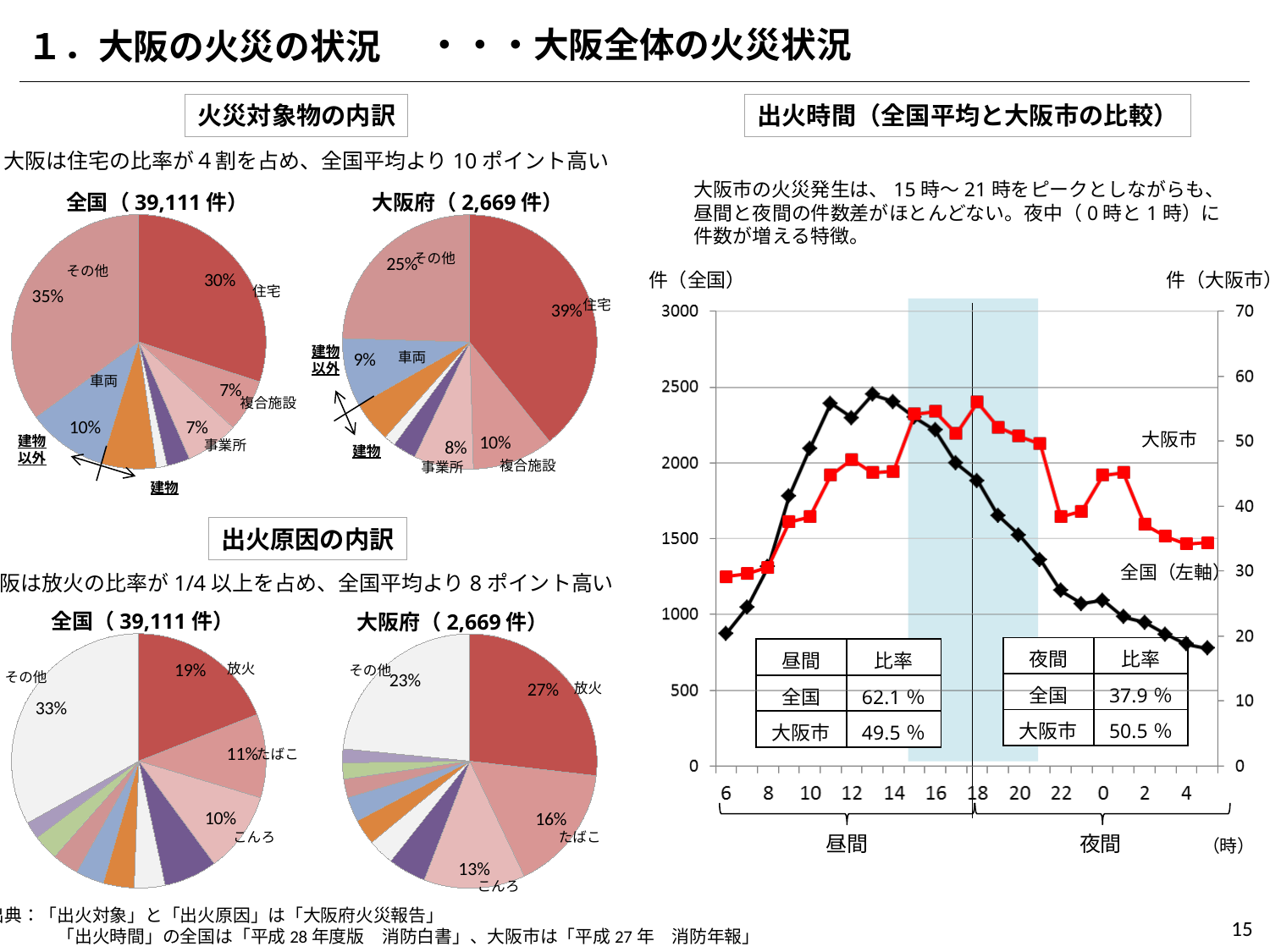
In the 出火時間 chart, is the 全国 value at 6時 greater or less than 1000? less In the 出火原因の内訳 pie chart for 大阪府 (2,669件), which is larger, たばこ or こんろ? たばこ In the 火災対象物の内訳 pie chart for 大阪府 (2,669件), what share is 住宅? 39% Comparing the 出火原因の内訳 pie charts, how many percentage points higher is the 放火 share for 大阪府 than for 全国? 8 In the 出火原因の内訳 pie chart for 全国 (39,111件), what share is 放火? 19% In the 火災対象物の内訳 pie chart for 全国 (39,111件), what share is 住宅? 30% In the 火災対象物の内訳 pie chart for 大阪府 (2,669件), what share is 車両? 9% In the 出火原因の内訳 pie chart for 大阪府 (2,669件), what share is 放火? 27% How many series are plotted in the 出火時間（全国平均と大阪市の比較） chart? 2 In the 火災対象物の内訳 pie chart for 全国 (39,111件), which category has the largest slice? その他 What kind of chart is the 出火時間（全国平均と大阪市の比較） chart? line chart In the table on the 出火時間 chart, what is the 夜間 比率 for 大阪市? 50.5 %